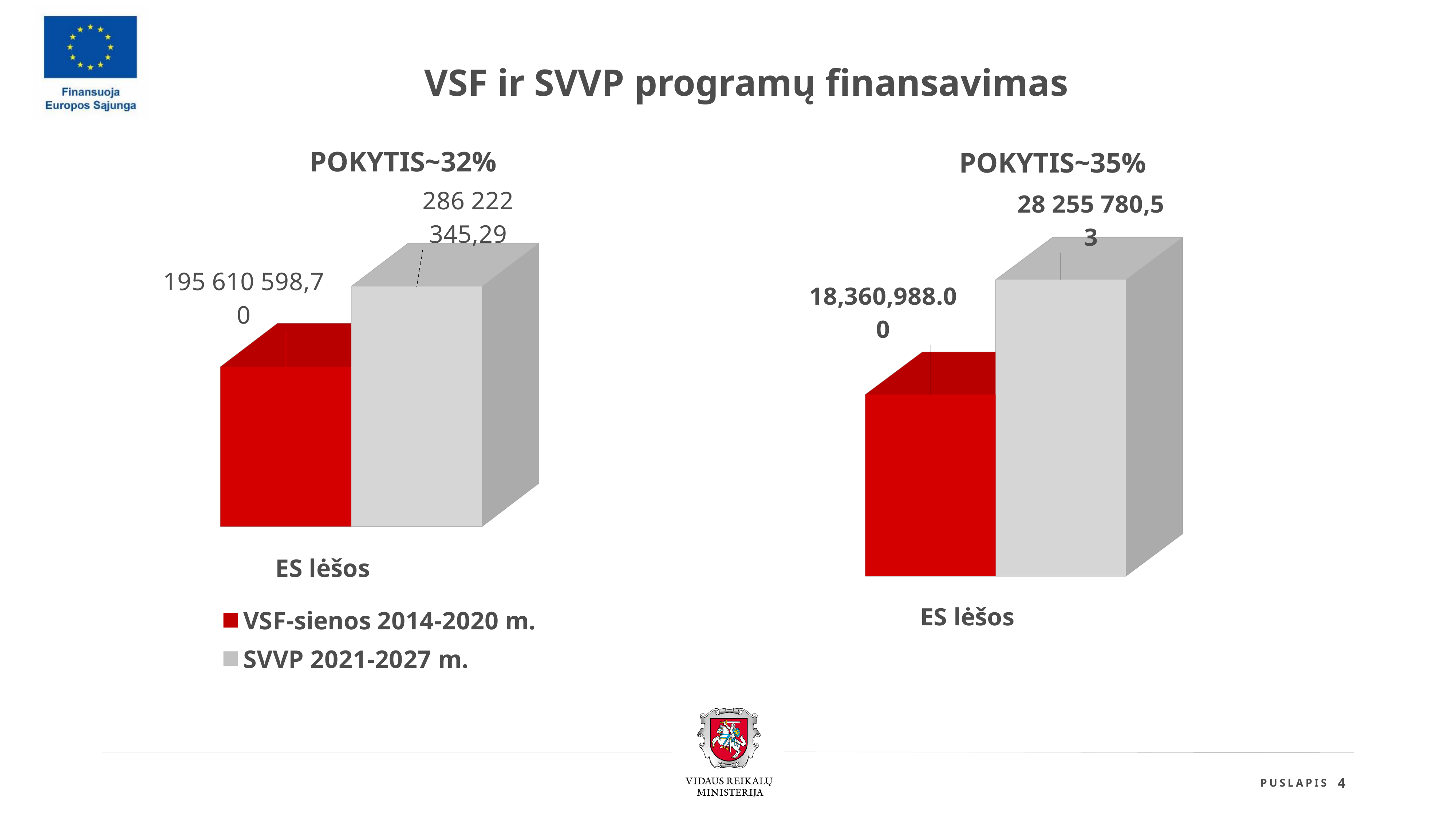
In the chart titled POKYTIS~32%, what is the difference between the SVVP 2021-2027 m. value and the VSF-sienos 2014-2020 m. value? 90 611 746,59 What is the category label on the x axis of the chart titled POKYTIS~32%? ES lėšos In the chart titled POKYTIS~35%, what is the value of the red bar? 18,360,988.00 In the chart titled POKYTIS~35%, is the red bar or the grey bar larger? the grey bar What is the title of the slide? VSF ir SVVP programų finansavimas How many series does the legend of the chart titled POKYTIS~32% list? 2 In the chart titled POKYTIS~32%, which series has the higher value? SVVP 2021-2027 m. In the chart titled POKYTIS~32%, what is the value of the VSF-sienos 2014-2020 m. bar? 195 610 598,70 In the chart titled POKYTIS~32%, what is the value of the SVVP 2021-2027 m. bar? 286 222 345,29 What type of chart is the chart titled POKYTIS~35%? bar chart In the chart titled POKYTIS~35%, what is the difference between the grey bar and the red bar? 9 894 792,53 In the chart titled POKYTIS~35%, what is the value of the grey bar? 28 255 780,53